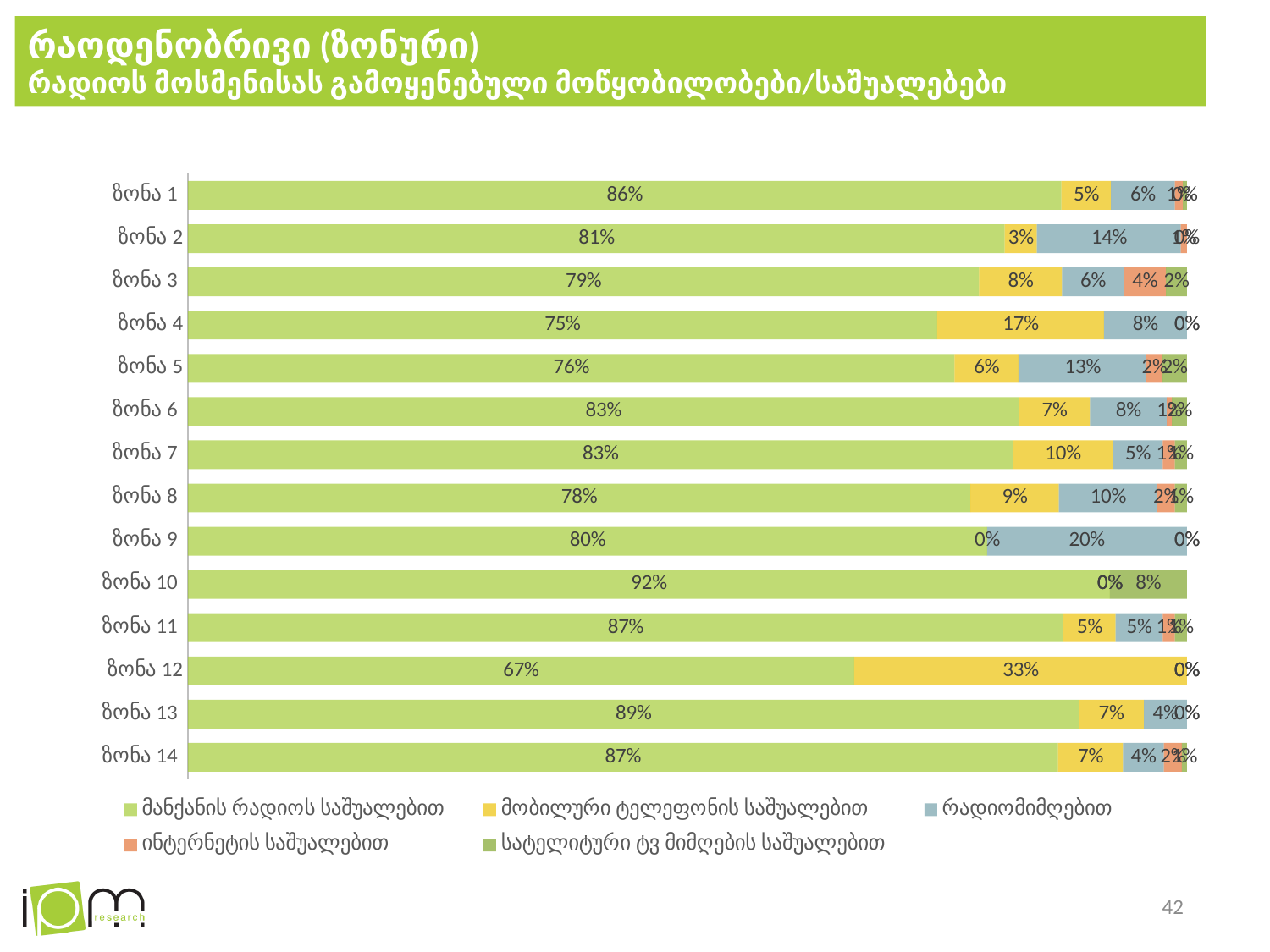
Which zone has the highest value for მობილური ტელეფონის საშუალებით? ზონა 12 How many series does the legend list? 5 Which zone has the highest value for მანქანის რადიოს საშუალებით? ზონა 10 Which zone has the lowest value for მანქანის რადიოს საშუალებით? ზონა 12 What is the value for რადიომიმღებით in ზონა 9? 20% Which is larger: the მობილური ტელეფონის საშუალებით value for ზონა 4 or for ზონა 5? ზონა 4 What kind of chart is shown on the slide? Stacked bar chart How many zones are shown in the chart? 14 What is the difference between the მანქანის რადიოს საშუალებით values for ზონა 10 and ზონა 12? 25% What percentage of respondents in ზონა 12 listen to radio via car radio (მანქანის რადიოს საშუალებით)? 67% What is the value for მანქანის რადიოს საშუალებით in ზონა 4? 75% What is the value for მობილური ტელეფონის საშუალებით in ზონა 12? 33%